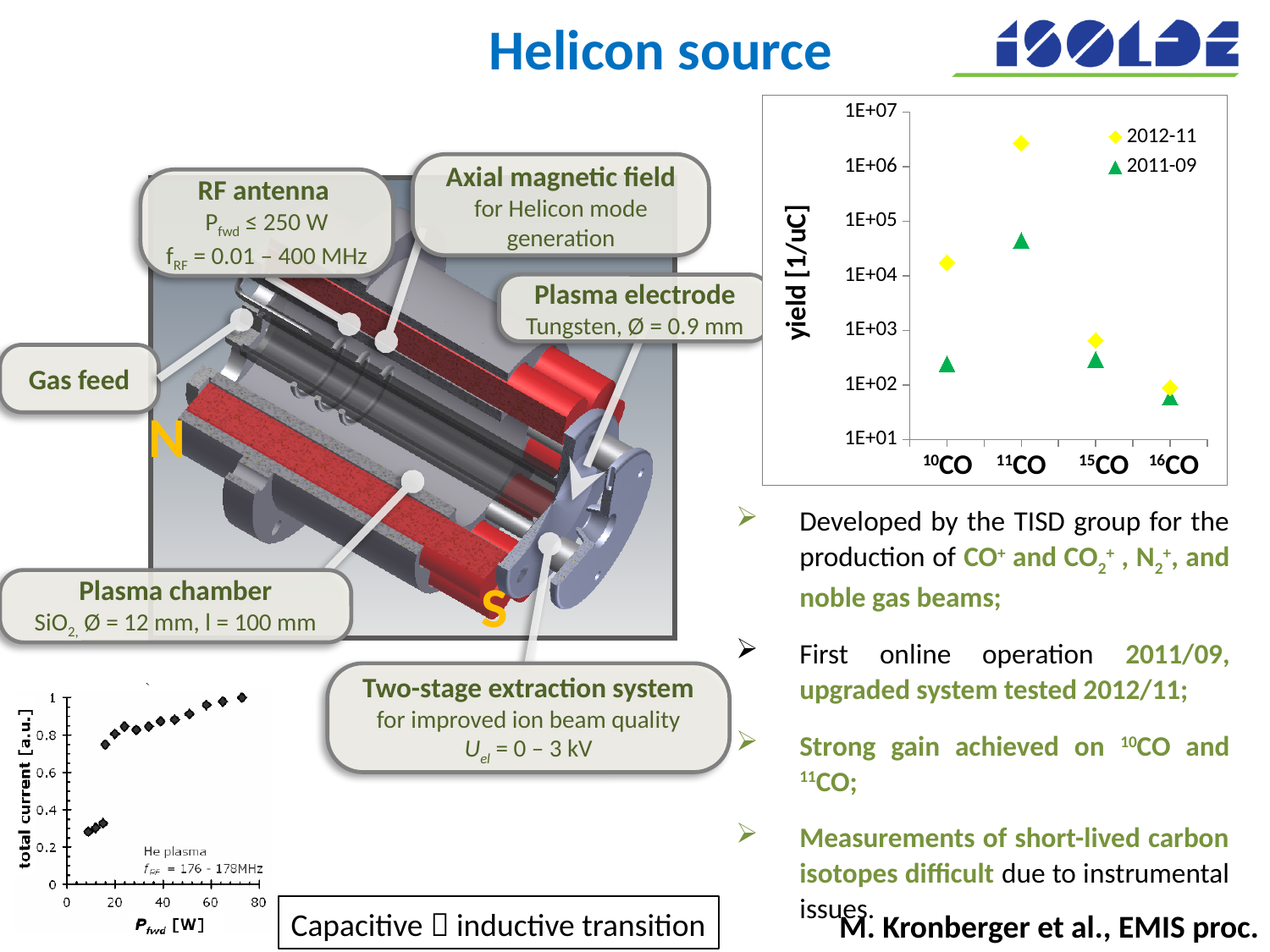
On the yield chart at the top right, which isotope has the highest yield for the 2012-11 series? 11CO On the total current chart at the bottom left, what is the label of the x axis? P_fwd [W] On the yield chart at the top right, which isotope has the lowest yield for the 2012-11 series? 16CO On the yield chart at the top right, is the 2011-09 yield for 10CO greater or less than 1E+03? less On the total current chart at the bottom left, does the total current rise or fall as P_fwd increases? rise On the yield chart at the top right, how many CO isotopes are shown on the x axis? 4 On the yield chart at the top right, what kind of chart is it? scatter chart On the yield chart at the top right, is the 2012-11 yield for 11CO greater or less than 1E+06? greater On the yield chart at the top right, how many series does the legend list? 2 On the yield chart at the top right, which isotope has the highest yield for the 2011-09 series? 11CO On the yield chart at the top right, for 10CO, which series has the larger yield, 2012-11 or 2011-09? 2012-11 On the yield chart at the top right, what is the label of the y axis? yield [1/uC]